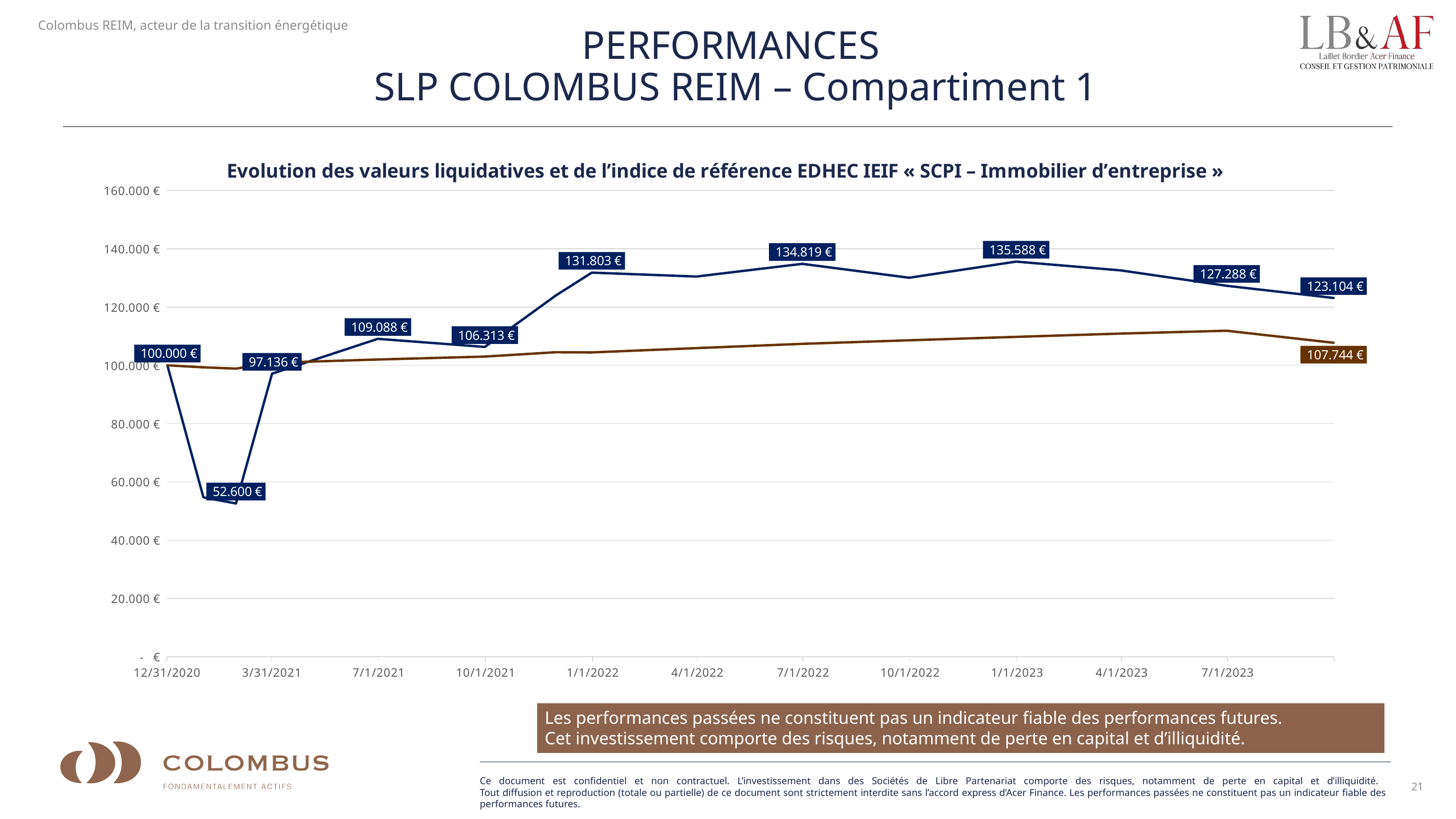
Which is larger: the labelled value 131.803 € or the labelled value 134.819 € on the dark blue line? 134.819 € What is the highest labelled value on the dark blue line? 135.588 € Is the value of the brown line at 7/1/2023 greater or less than 120.000 €? less How many data labels are shown on the dark blue line? 10 What is the lowest labelled value on the dark blue line? 52.600 € What is the difference between the highest labelled value on the dark blue line (135.588 €) and its last labelled value (123.104 €)? 12.484 € What kind of chart is shown on the slide? line chart What is the difference between the final labelled value of the dark blue line (123.104 €) and the final labelled value of the brown line (107.744 €)? 15.360 € What is the labelled value at the end of the brown line? 107.744 € What is the last labelled value of the dark blue line? 123.104 € What is the title of the chart? Evolution des valeurs liquidatives et de l'indice de référence EDHEC IEIF « SCPI – Immobilier d'entreprise » What is the first labelled value of the dark blue line at 12/31/2020? 100.000 €